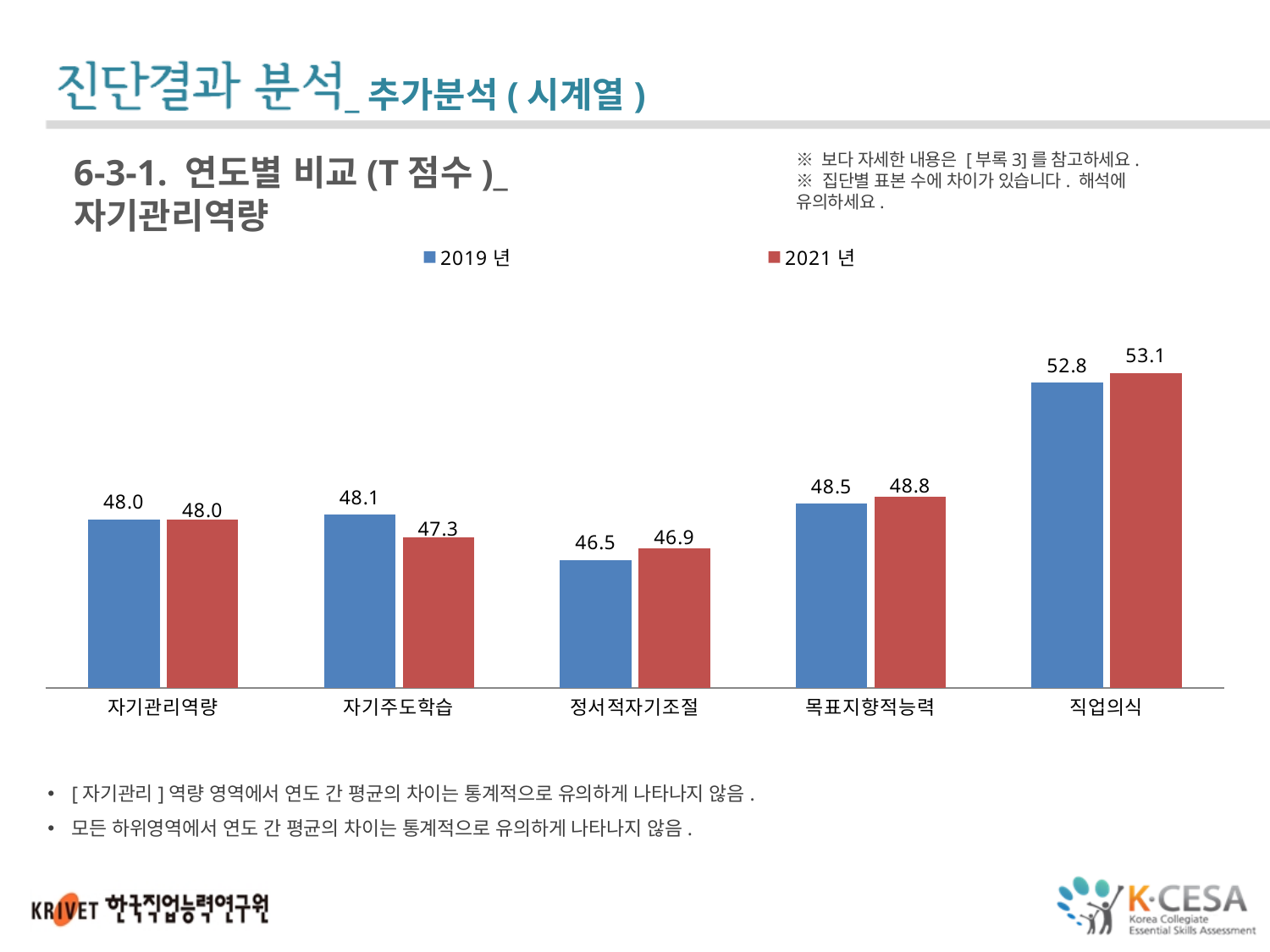
How many categories are shown on the x axis? 5 What is the 2019년 value for 직업의식? 52.8 What is the difference between the 2019년 and 2021년 values for 자기주도학습? 0.8 How many series does the legend list? 2 Which category has the highest 2021년 value? 직업의식 What is the difference between the 2021년 and 2019년 values for 직업의식? 0.3 Which category has the lowest 2019년 value? 정서적자기조절 What is the 2021년 value for 정서적자기조절? 46.9 What kind of chart is shown on the slide? bar chart What is the 2019년 value for 목표지향적능력? 48.5 What is the 2021년 value for 자기주도학습? 47.3 Which is larger for 목표지향적능력, the 2019년 value or the 2021년 value? 2021년